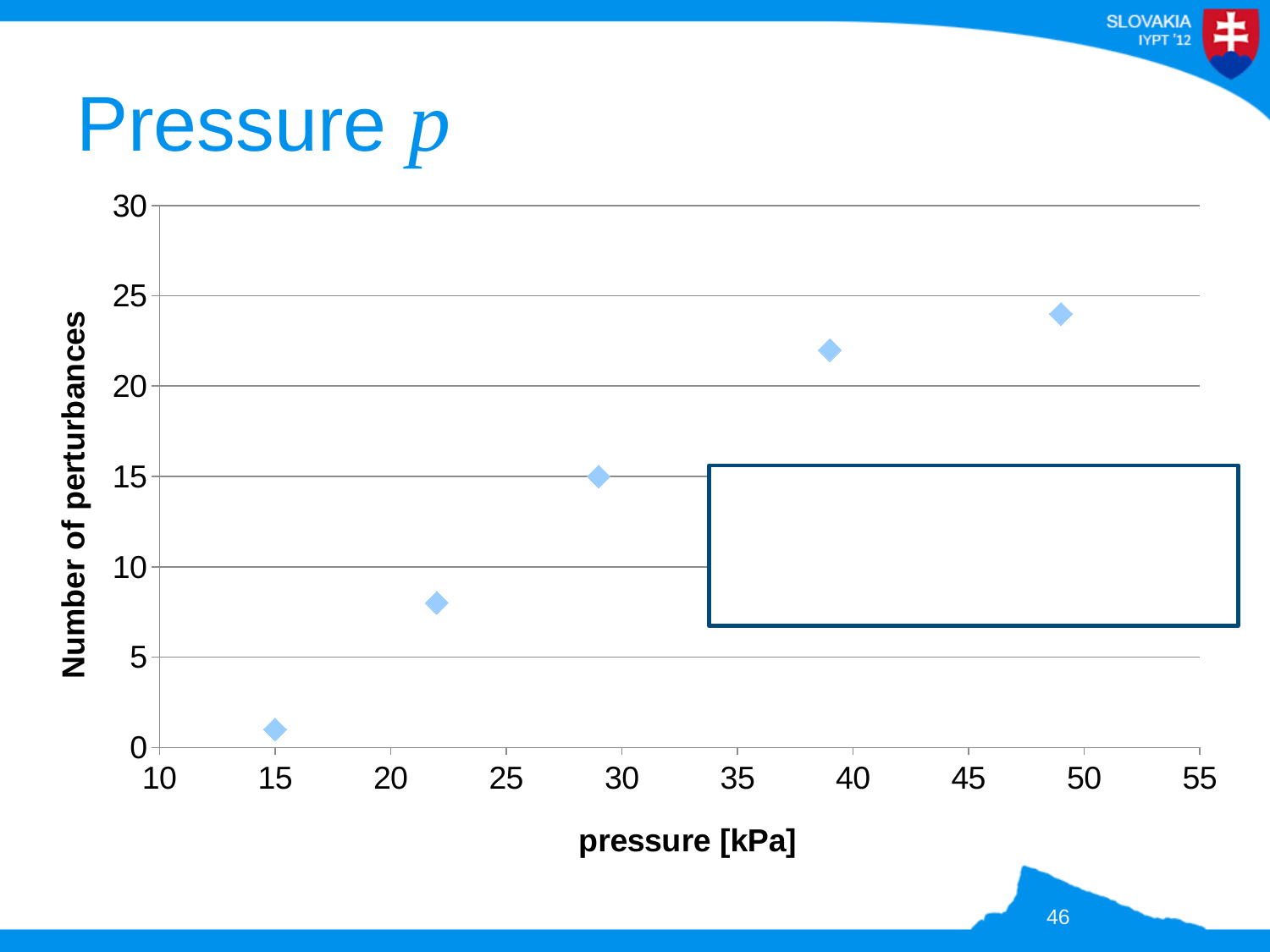
What kind of chart is shown on the slide? scatter chart Does the number of perturbances rise or fall as pressure increases along the x axis? rise Which has more perturbances: the second point from the left or the third point from the left? the third point from the left Is the number of perturbances at 15 kPa greater or less than 5? less Is the number of perturbances for the fourth point from the left greater or less than 20? greater What is the label of the y axis? Number of perturbances What is the label of the x axis? pressure [kPa] Does the point with the highest number of perturbances have the highest or the lowest pressure on the chart? highest Is the number of perturbances for the second point from the left greater or less than 10? less At what pressure is the lowest number of perturbances plotted? 15 kPa How many data points are plotted on the chart? 5